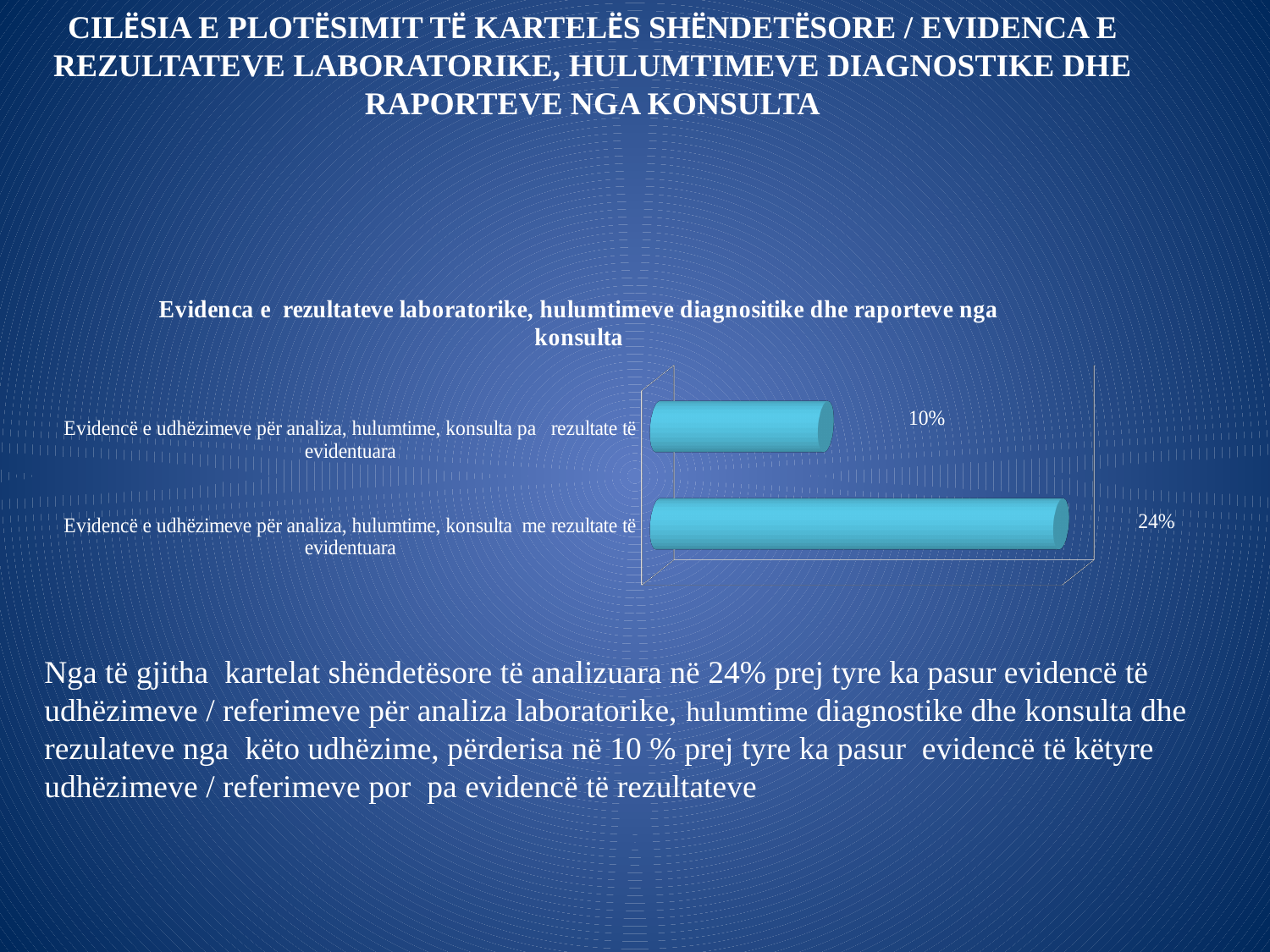
Which category has the lowest value? Evidencë e udhëzimeve për analiza, hulumtime, konsulta pa rezultate të evidentuara Which is larger: the value for 'pa rezultate të evidentuara' or the value for 'me rezultate të evidentuara'? me rezultate të evidentuara What colour are the bars in the chart? Light blue What is the value for 'Evidencë e udhëzimeve për analiza, hulumtime, konsulta pa rezultate të evidentuara'? 10% Which category has the highest value? Evidencë e udhëzimeve për analiza, hulumtime, konsulta me rezultate të evidentuara What is the title of the chart? Evidenca e rezultateve laboratorike, hulumtimeve diagnositike dhe raporteve nga konsulta What kind of chart is shown on the slide? Bar chart What is the value for 'Evidencë e udhëzimeve për analiza, hulumtime, konsulta me rezultate të evidentuara'? 24% What is the difference between the value for 'me rezultate të evidentuara' and the value for 'pa rezultate të evidentuara'? 14% How many categories are shown in the chart? 2